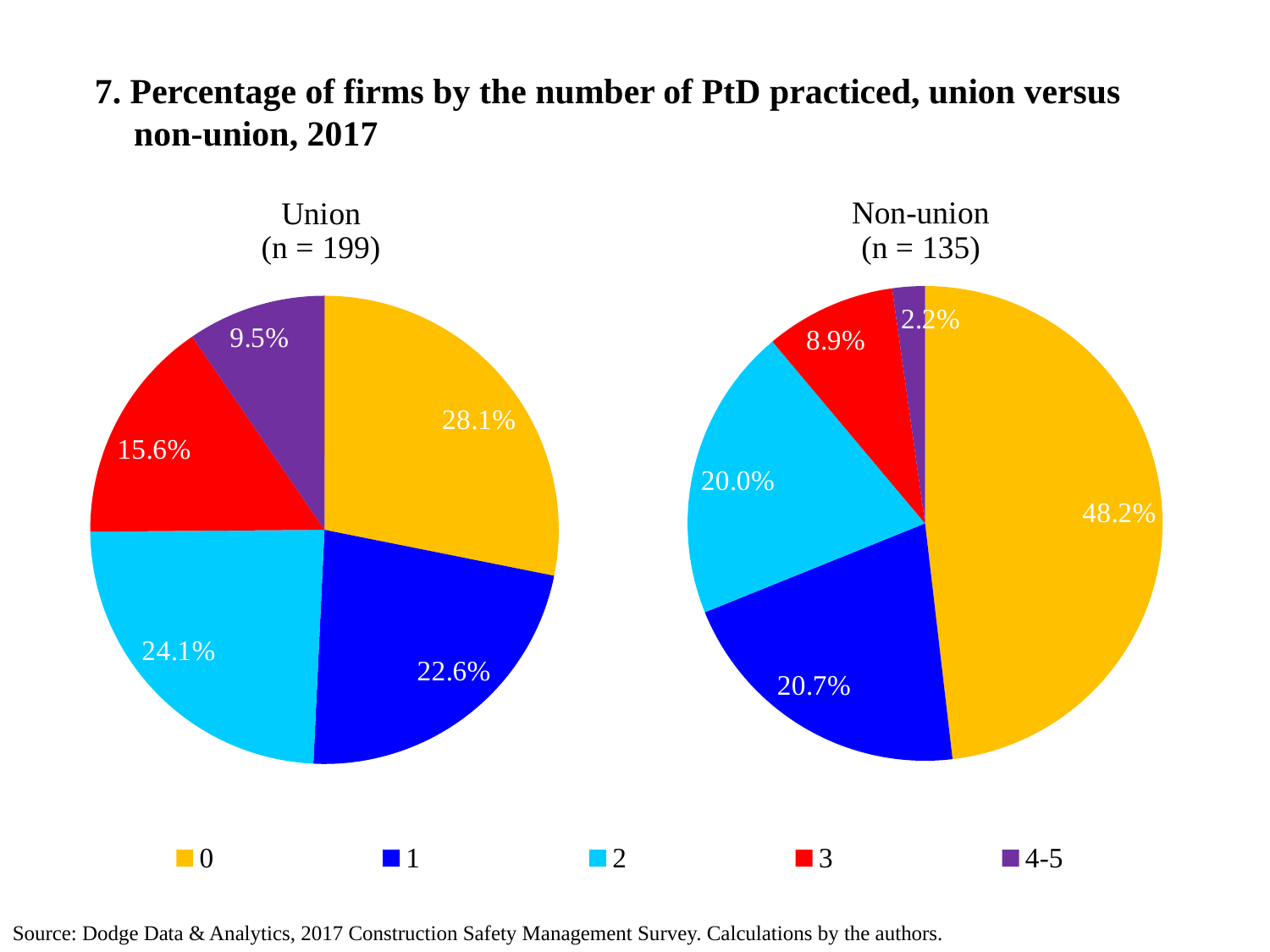
In the Non-union pie chart, what percentage of firms practiced 0 PtD? 48.2% In the Union pie chart, what percentage of firms practiced 4-5 PtD? 9.5% Which is larger: the share for 3 in the Union chart or the share for 3 in the Non-union chart? Union In the Non-union pie chart, which category has the smallest share? 4-5 In the Union pie chart, what is the difference between the share for 2 and the share for 1? 1.5% What kind of chart is used on this slide? Pie chart In the Union pie chart, what percentage of firms practiced 0 PtD? 28.1% Which colour represents the category 2 in the legend? Light blue How many categories does the legend list? 5 What is the sample size (n) shown for the Non-union chart? 135 In the Union pie chart, which category has the largest share? 0 In the Non-union pie chart, what percentage of firms practiced 3 PtD? 8.9%